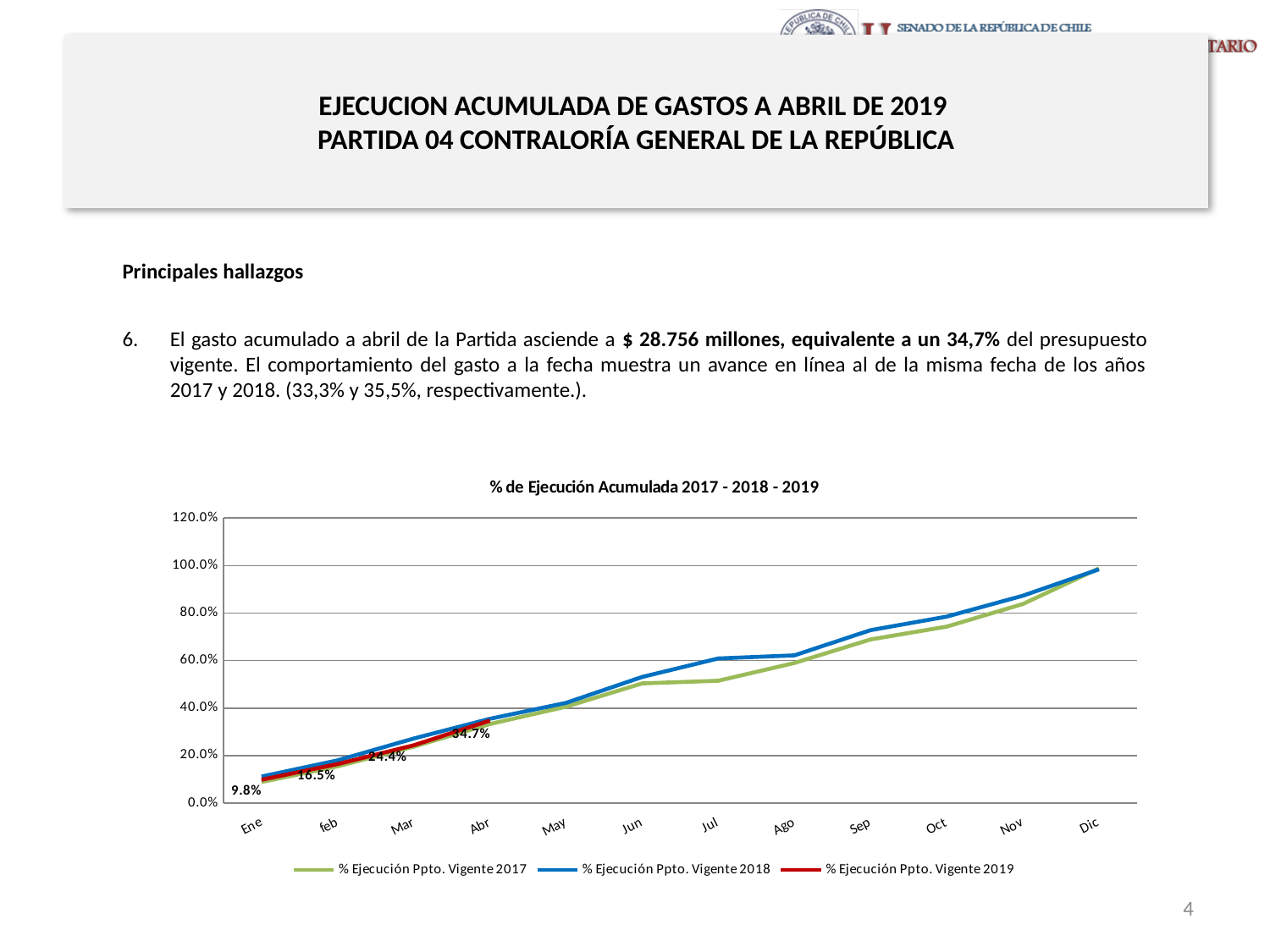
What is the value of % Ejecución Ppto. Vigente 2019 in Feb? 16.5% What is the value of % Ejecución Ppto. Vigente 2019 in Ene? 9.8% What is the difference between the 2019 values for Abr and Mar? 10.3% What kind of chart is shown? Line chart How many months are shown on the x axis? 12 How many series does the legend list? 3 Do the values of % Ejecución Ppto. Vigente 2018 rise or fall from Ene to Dic? Rise What is the value of % Ejecución Ppto. Vigente 2019 in Abr? 34.7% What is the title of the chart? % de Ejecución Acumulada 2017 - 2018 - 2019 Which month has the highest value for % Ejecución Ppto. Vigente 2019? Abr What is the value of % Ejecución Ppto. Vigente 2019 in Mar? 24.4% Is the value for % Ejecución Ppto. Vigente 2017 in Jul greater or less than 60.0%? less